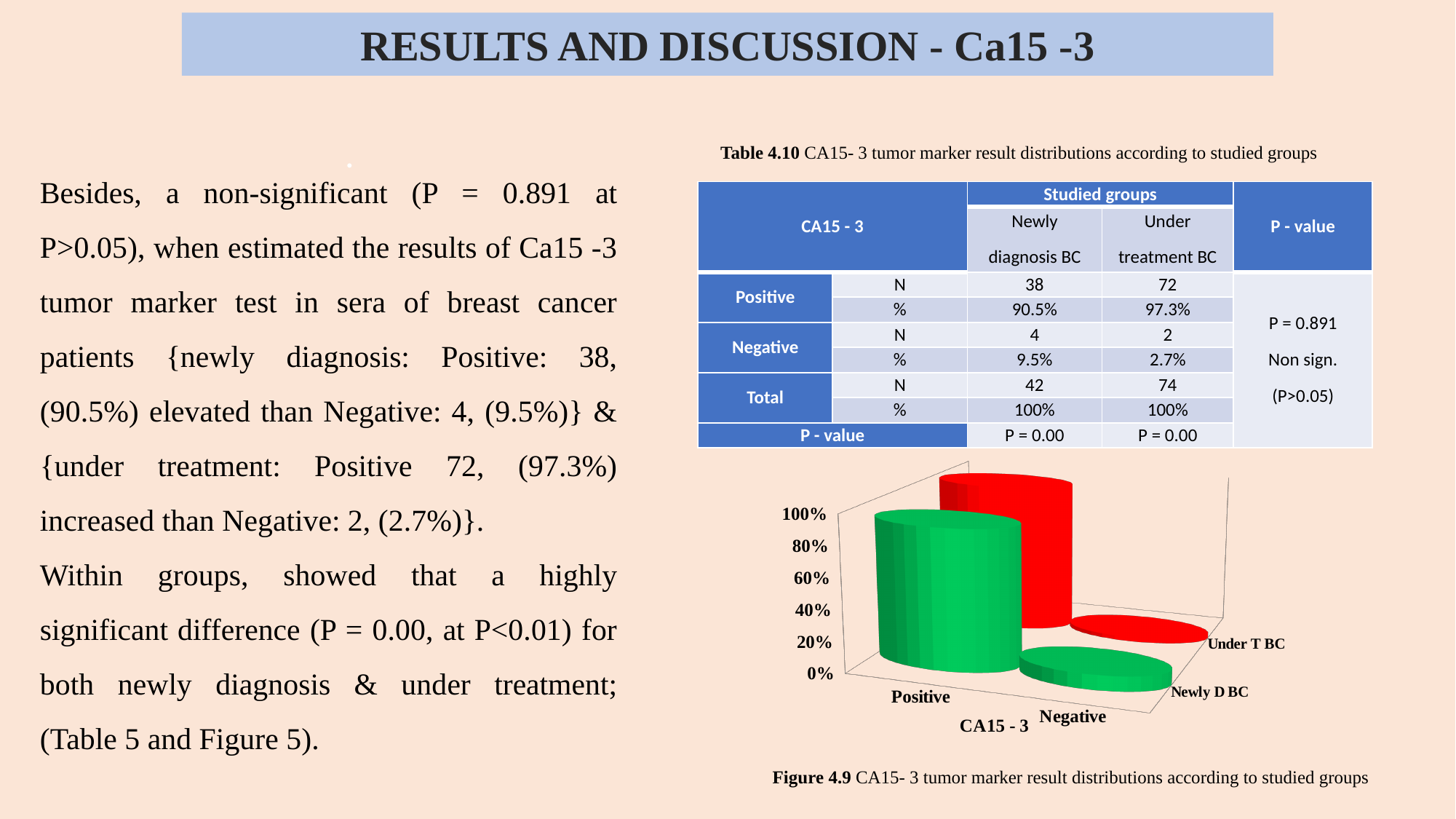
How many categories are shown on the x axis of the chart? 2 How many series does the chart show? 2 Which category has the lowest value for the Under T BC series in the chart? Negative What colour are the bars for the Under T BC series in the chart? red In the chart, is the Newly D BC value for Negative greater or less than 40%? less Which category has the highest value for the Newly D BC series in the chart? Positive What label is shown on the x axis of the chart? CA15 - 3 For the Newly D BC series in the chart, which is larger: Positive or Negative? Positive In the chart, is the Newly D BC value for Positive greater or less than 80%? greater In the chart, is the Under T BC value for Negative greater or less than 20%? less What kind of chart is shown in Figure 4.9? bar chart